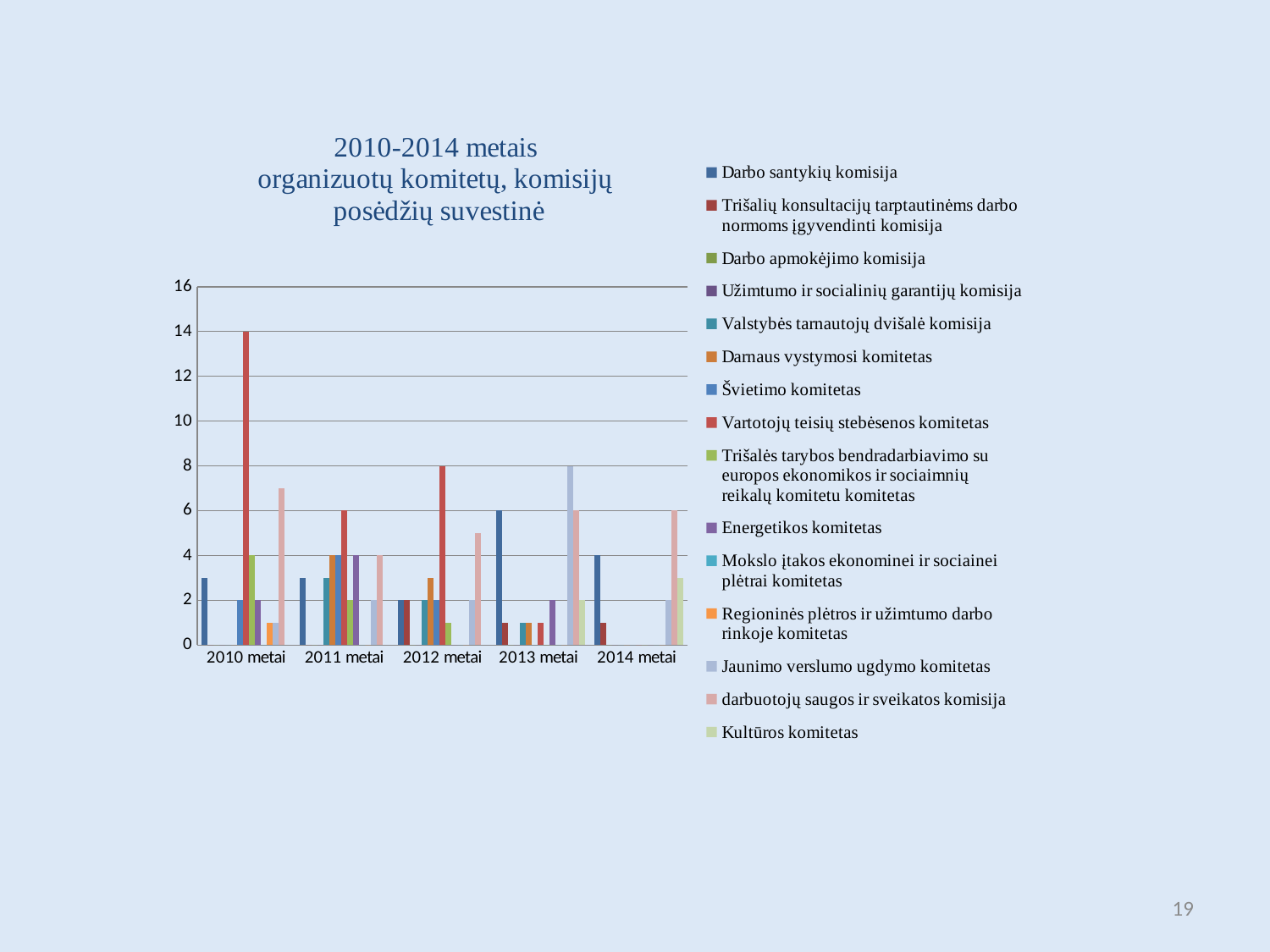
Is the value for Trišalių konsultacijų tarptautinėms darbo normoms įgyvendinti komisija in 2010 metai greater or less than 12? less What kind of chart is shown on the slide? bar chart In which year does the tallest bar on the chart appear? 2010 metai What is the highest value shown on the vertical axis? 16 How many year categories are shown on the x axis? 5 How many series does the legend list? 15 Which is larger for Darbo santykių komisija: the value in 2013 metai or in 2010 metai? 2013 metai What is the value for Darbo santykių komisija in 2013 metai? 6 What is the title of the chart? 2010-2014 metais organizuotų komitetų, komisijų posėdžių suvestinė